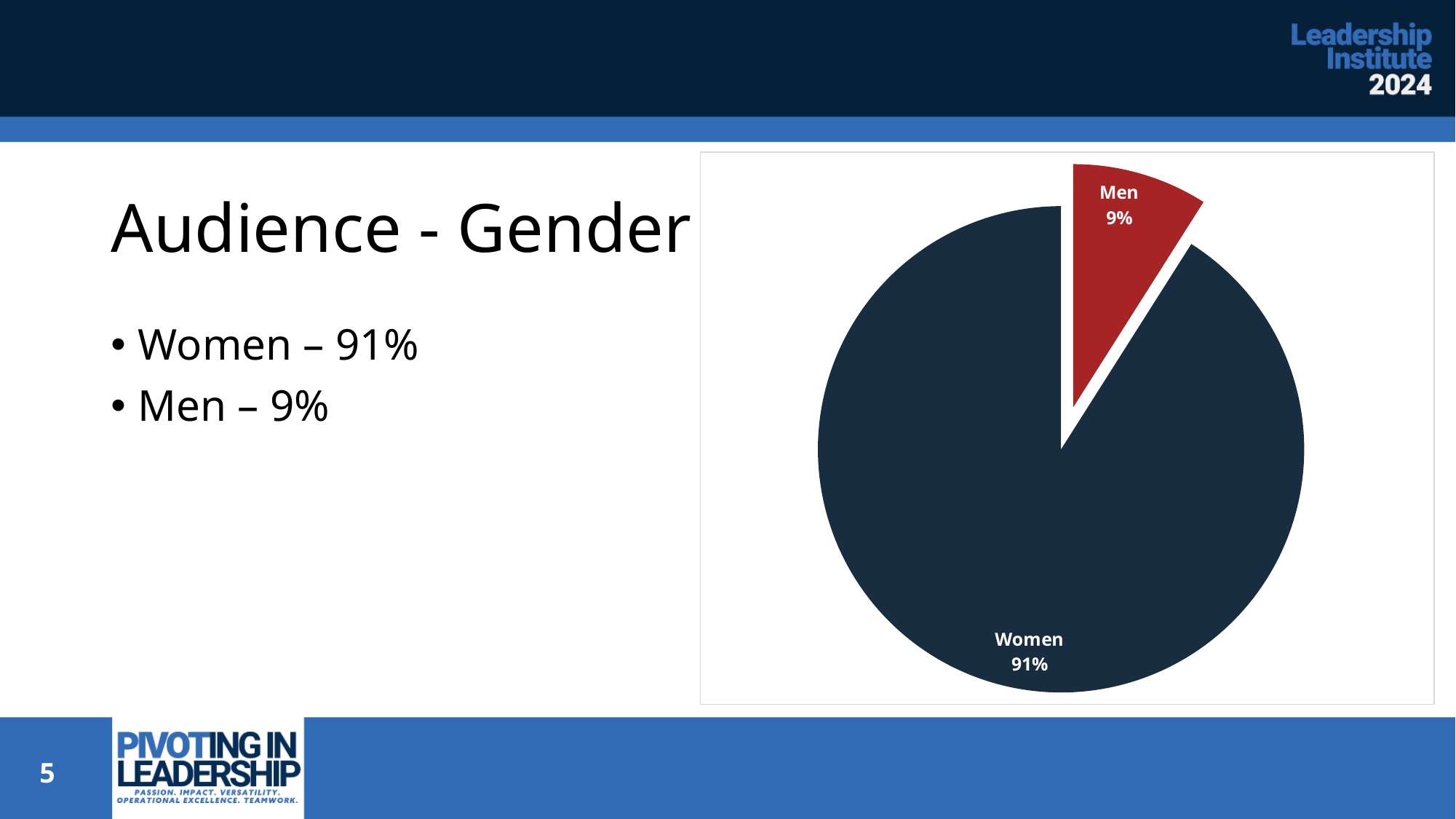
What kind of chart is shown on the slide? Pie chart What is the difference in percentage points between the Women and Men slices? 82 What colour is the Men slice in the pie chart? Red Which is larger, the Women slice or the Men slice? Women What share of the audience is Men according to the pie chart? 9% What is the title of the slide containing the pie chart? Audience - Gender What share of the audience is Women according to the pie chart? 91% What is the combined total of the Women and Men slices? 100% Which slice of the pie chart is the smallest? Men How many slices does the pie chart have? 2 Which slice of the pie chart is the largest? Women